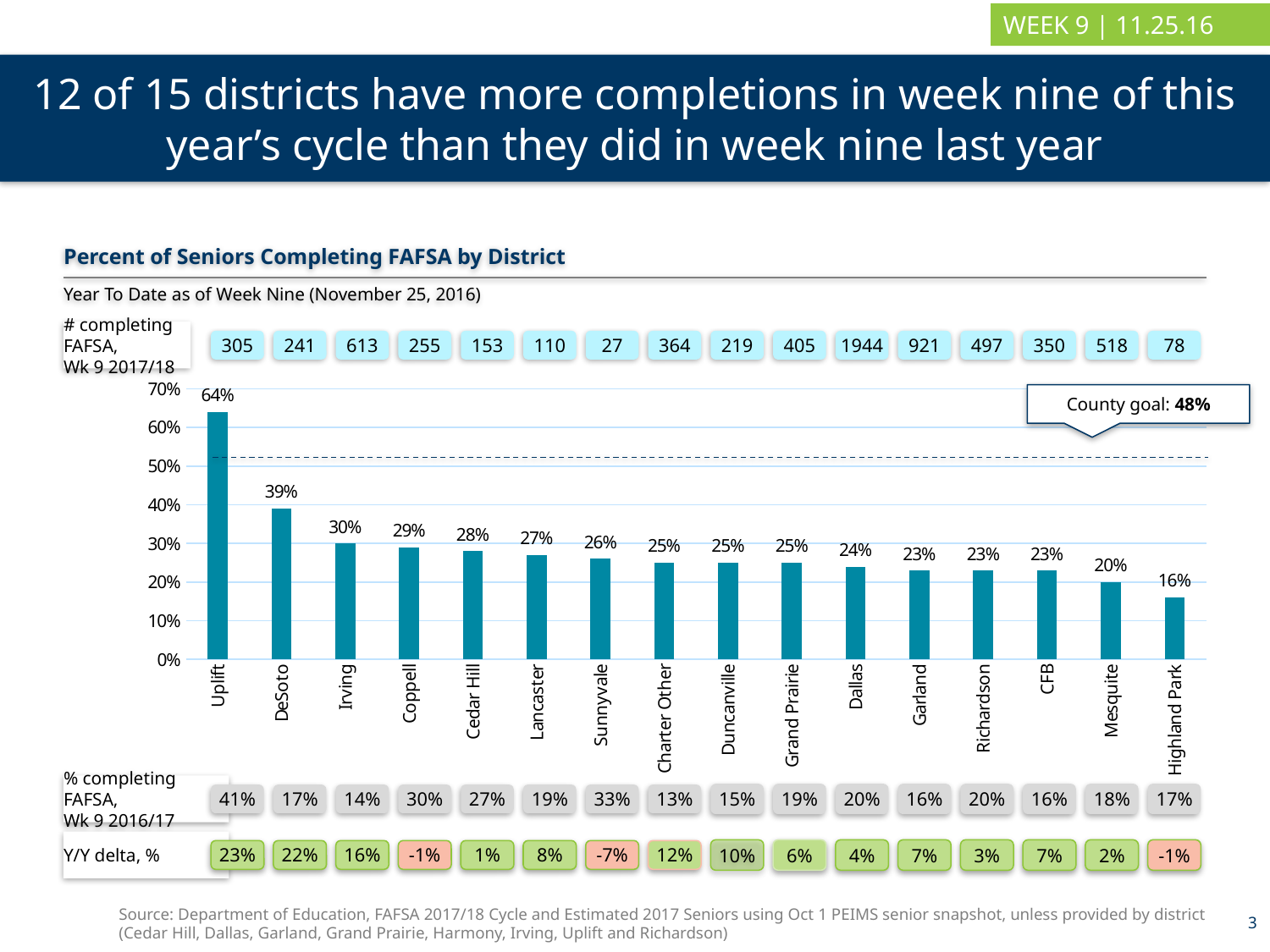
What kind of chart is shown on the slide? bar chart What is the difference between the values for Irving and Highland Park? 14% Which has a higher value, DeSoto or Coppell? DeSoto What is the difference between the values for Uplift and DeSoto? 25% What is the county goal shown on the chart? 48% What is the value shown for Cedar Hill? 28% What percent of seniors completed FAFSA in Uplift? 64% Is the value for Lancaster greater or less than 30%? less What is the value shown for Mesquite? 20% Which district has the lowest percent of seniors completing FAFSA? Highland Park Which district has the highest percent of seniors completing FAFSA? Uplift How many districts are shown on the x axis of the chart? 16